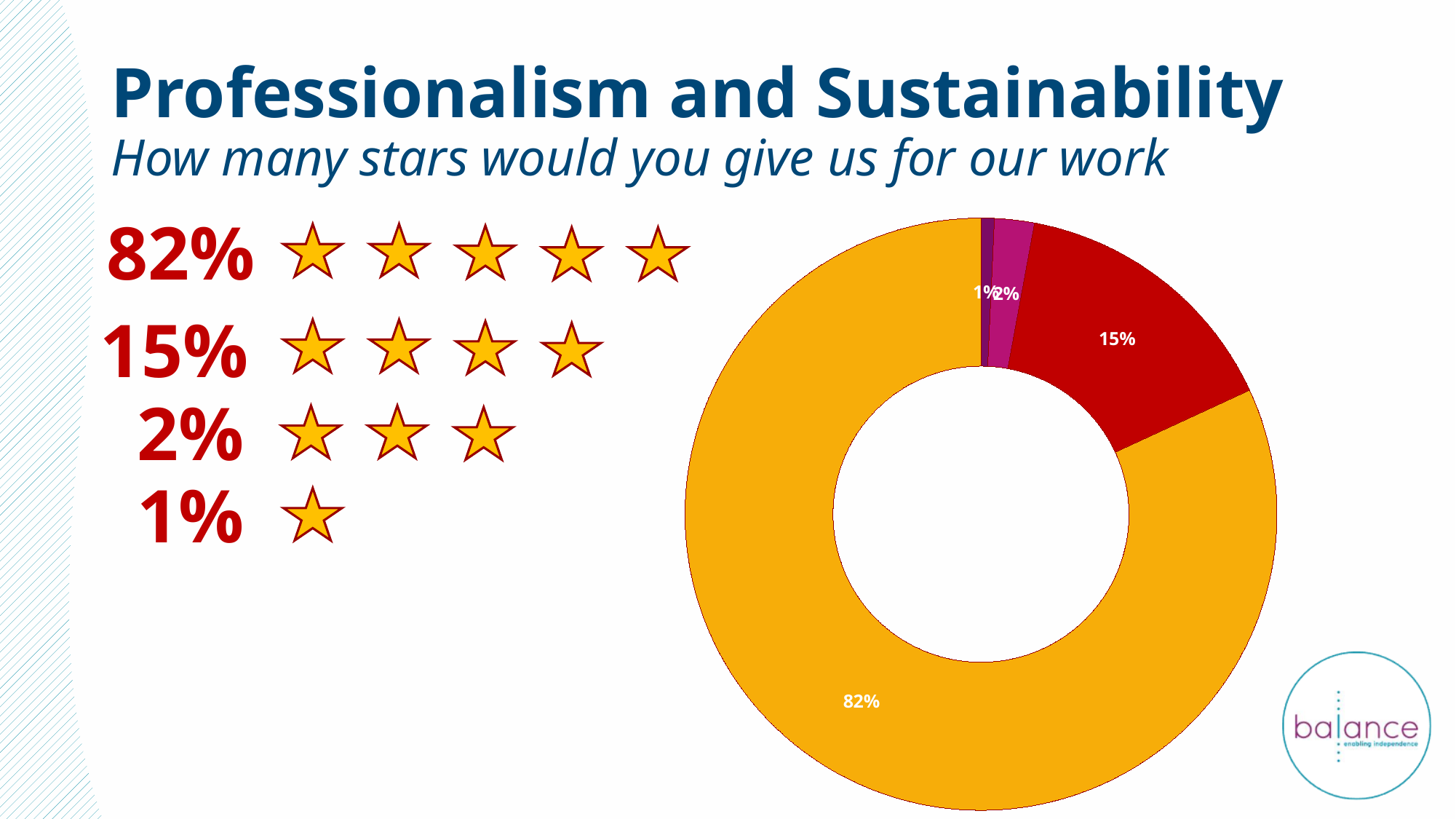
How many slices does the doughnut chart have? 4 What percentage of respondents gave one star? 1% What percentage of respondents gave five stars? 82% What kind of chart is shown on the slide? Doughnut chart Which is larger, the share for four stars or the share for three stars? Four stars What percentage of respondents gave four stars? 15% Which star rating has the smallest share of the chart? One star What question is the chart answering, according to the subtitle? How many stars would you give us for our work What colour is the largest slice of the doughnut chart? Orange What percentage of respondents gave three stars? 2% Which star rating has the largest share of the chart? Five stars What is the difference between the five-star share and the four-star share? 67%